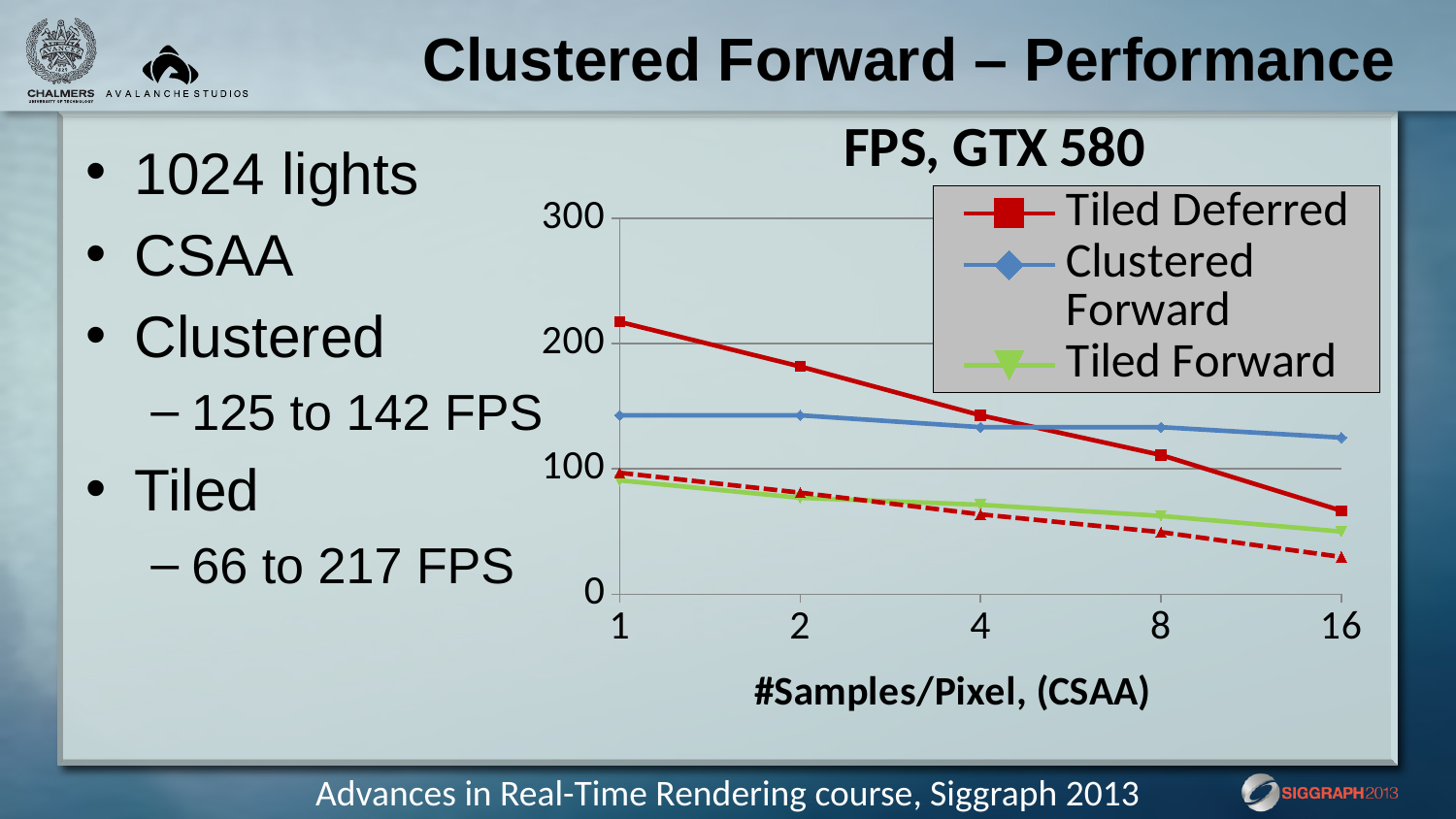
Is the Clustered Forward value at 1 sample/pixel greater or less than 100? greater Is the Tiled Deferred value at 1 sample/pixel greater or less than 200? greater How many series does the chart's legend list? 3 What is the label of the x axis of the chart? #Samples/Pixel, (CSAA) At 1 sample/pixel, which is larger: Tiled Deferred or Clustered Forward? Tiled Deferred Is the Tiled Deferred value at 16 samples/pixel greater or less than 100? less What is the title of the chart? FPS, GTX 580 What kind of chart is shown on the slide? line chart At 16 samples/pixel, which is larger: Clustered Forward or Tiled Deferred? Clustered Forward Does the Tiled Deferred series rise or fall as the number of samples per pixel increases? fall How many sample-per-pixel categories are plotted along the x axis? 5